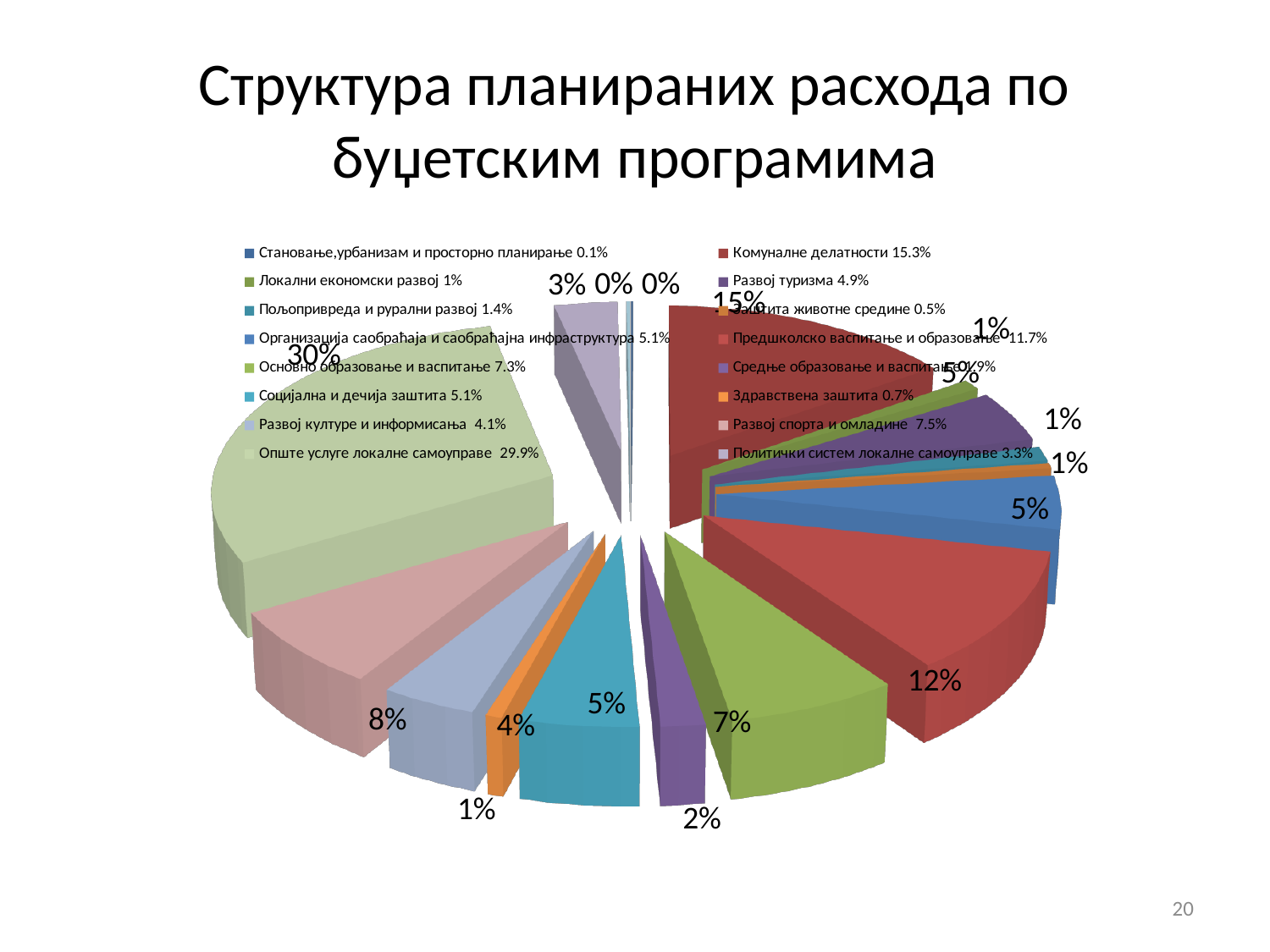
What percentage is shown in the legend for Комуналне делатности? 15.3% What is the difference in percentage points between Опште услуге локалне самоуправе and Комуналне делатности? 14.6 Which category has the smallest share of the pie? Становање,урбанизам и просторно планирање What percentage is shown in the legend for Политички систем локалне самоуправе? 3.3% Which category has the largest share of the pie? Опште услуге локалне самоуправе How many categories does the legend of the pie chart list? 16 What percentage is shown in the legend for Предшколско васпитање и образовање? 11.7% What is the title of the slide? Структура планираних расхода по буџетским програмима Which has a larger share: Развој туризма or Развој културе и информисања? Развој туризма What is the difference in percentage points between Основно образовање и васпитање and Средње образовање и васпитање? 5.4 What percentage is shown in the legend for Развој спорта и омладине? 7.5% What kind of chart is shown on the slide? Pie chart